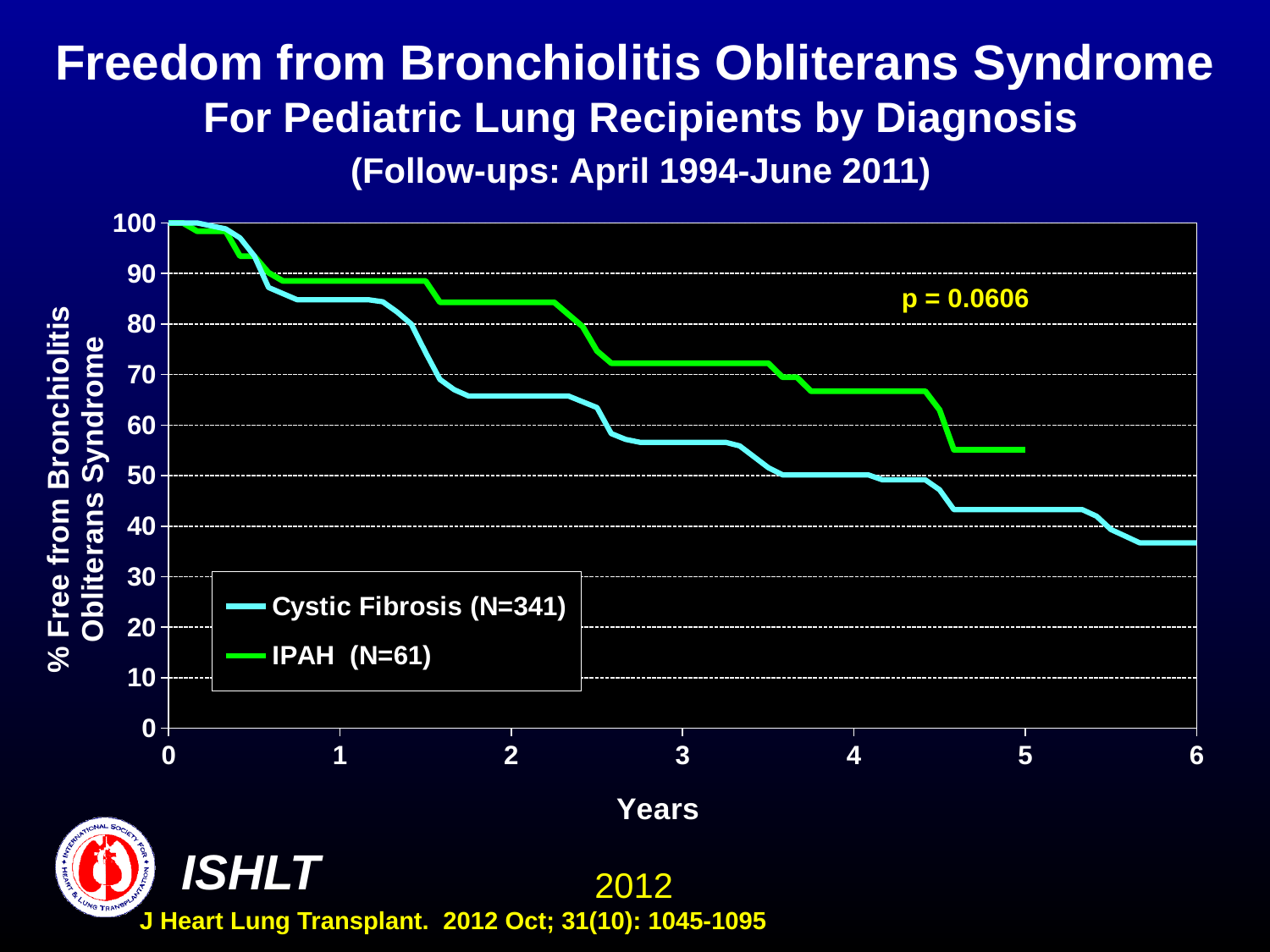
How many series does the legend list? 2 What p-value is printed on the chart? p = 0.0606 Is the value for IPAH at year 4 greater or less than 60? greater Which two groups are compared in the legend? Cystic Fibrosis (N=341) and IPAH (N=61) At year 0, what is the % free from Bronchiolitis Obliterans Syndrome for both groups? 100 Is the value for Cystic Fibrosis at year 6 greater or less than 40? less What kind of chart is shown on the slide? Line chart Is the value for IPAH at year 2 greater or less than 80? greater At year 3, which group has the higher % free from Bronchiolitis Obliterans Syndrome, Cystic Fibrosis or IPAH? IPAH Do the values for Cystic Fibrosis rise or fall as years increase? Fall